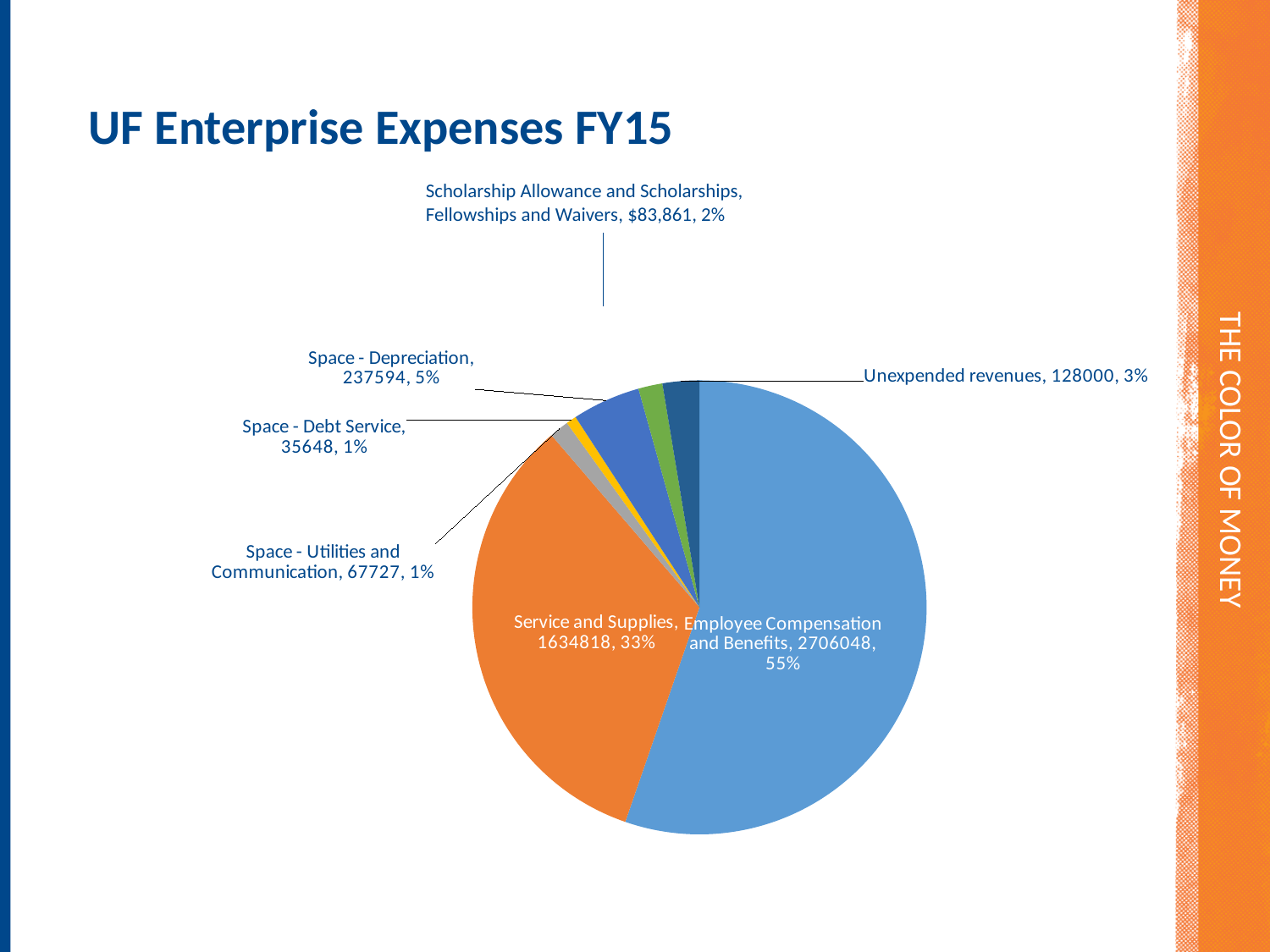
Which category has the largest slice of the pie? Employee Compensation and Benefits What share of the pie does Service and Supplies represent? 33% What is the value for Employee Compensation and Benefits? 2706048 What share of the pie does Space - Depreciation represent? 5% What is the value for Scholarship Allowance and Scholarships, Fellowships and Waivers? $83,861 What is the value for Space - Depreciation? 237594 What kind of chart is shown on the slide? pie chart How many slices does the pie chart have? 7 What is the value for Service and Supplies? 1634818 What is the value for Unexpended revenues? 128000 Which category has the smallest slice of the pie? Space - Debt Service What is the difference between the values for Space - Utilities and Communication and Space - Debt Service? 32079